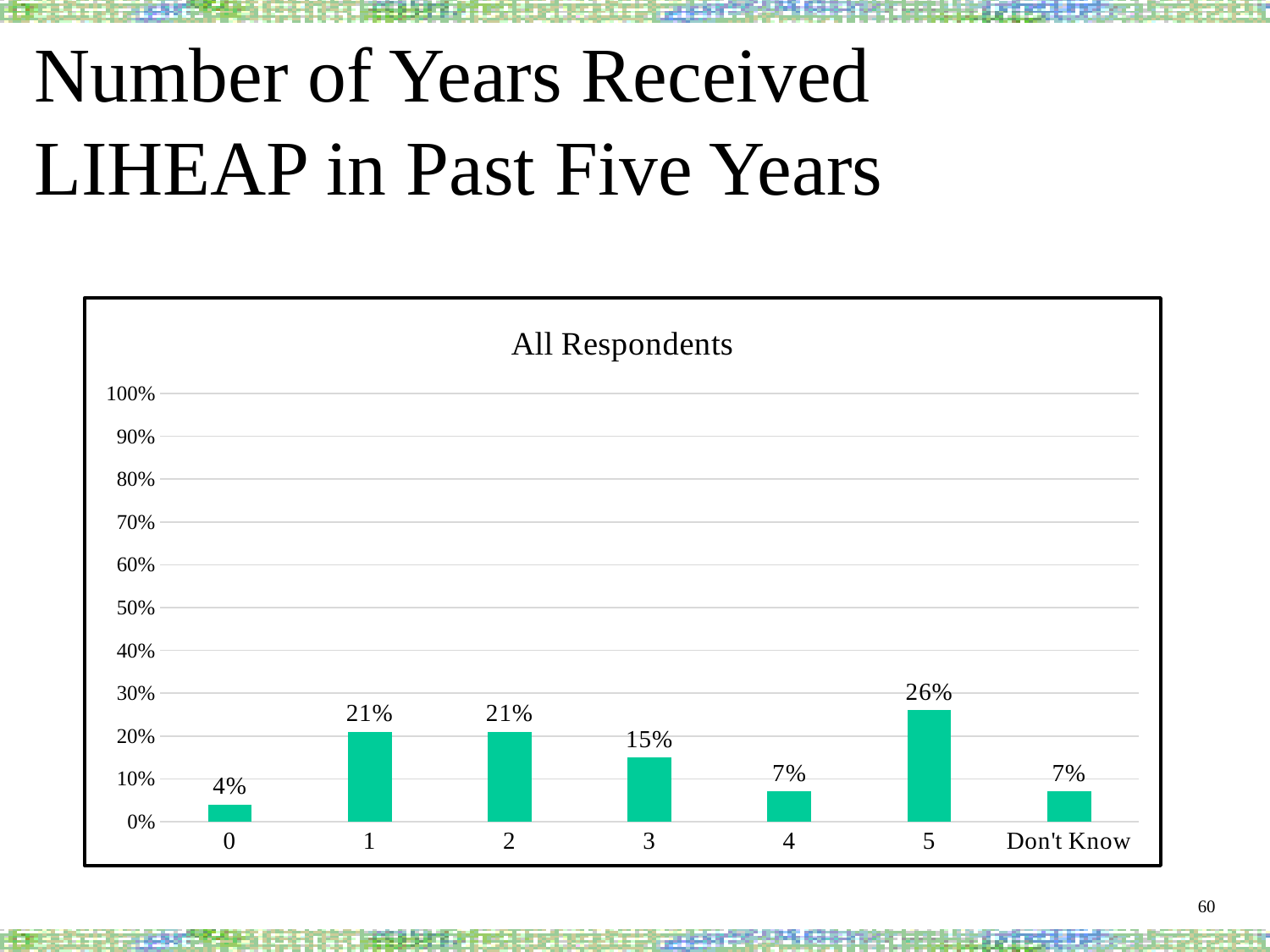
How many categories are shown on the x axis? 7 Which is larger, the value for 1 year or the value for 4 years? 1 year Which category has the highest value? 5 What percentage of respondents answered 'Don't Know'? 7% What is the difference between the value for 5 years and the value for 3 years? 11% Is the value for 5 years greater or less than 20%? greater What kind of chart is shown on the slide? Bar chart What is the value shown for the '0' years category? 4% What percentage of respondents received LIHEAP for 5 years in the past five years? 26% What is the highest value shown on the y axis? 100% Which category has the lowest value? 0 What is the title of the chart? All Respondents